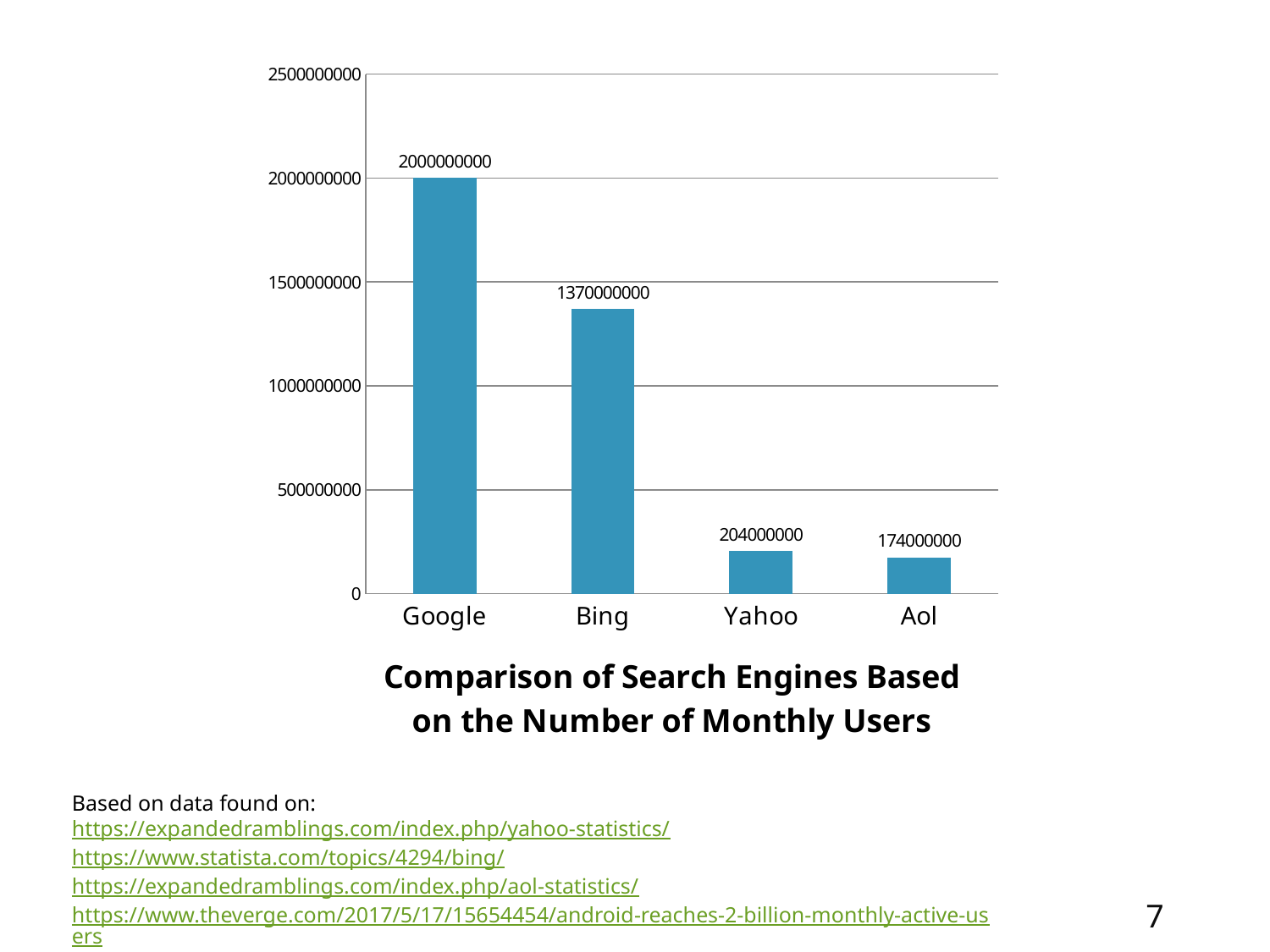
Which search engine has the lowest number of monthly users? Aol What is the number of monthly users for Yahoo? 204000000 What is the difference in monthly users between Yahoo and Aol? 30000000 What is the number of monthly users for Google? 2000000000 Which search engine has the highest number of monthly users? Google Which has more monthly users, Bing or Yahoo? Bing How many search engines are shown in the chart? 4 What type of chart is shown on the slide? Bar chart Is the value for Bing greater or less than 1500000000? less What is the number of monthly users for Bing? 1370000000 What is the number of monthly users for Aol? 174000000 What is the difference in monthly users between Google and Bing? 630000000